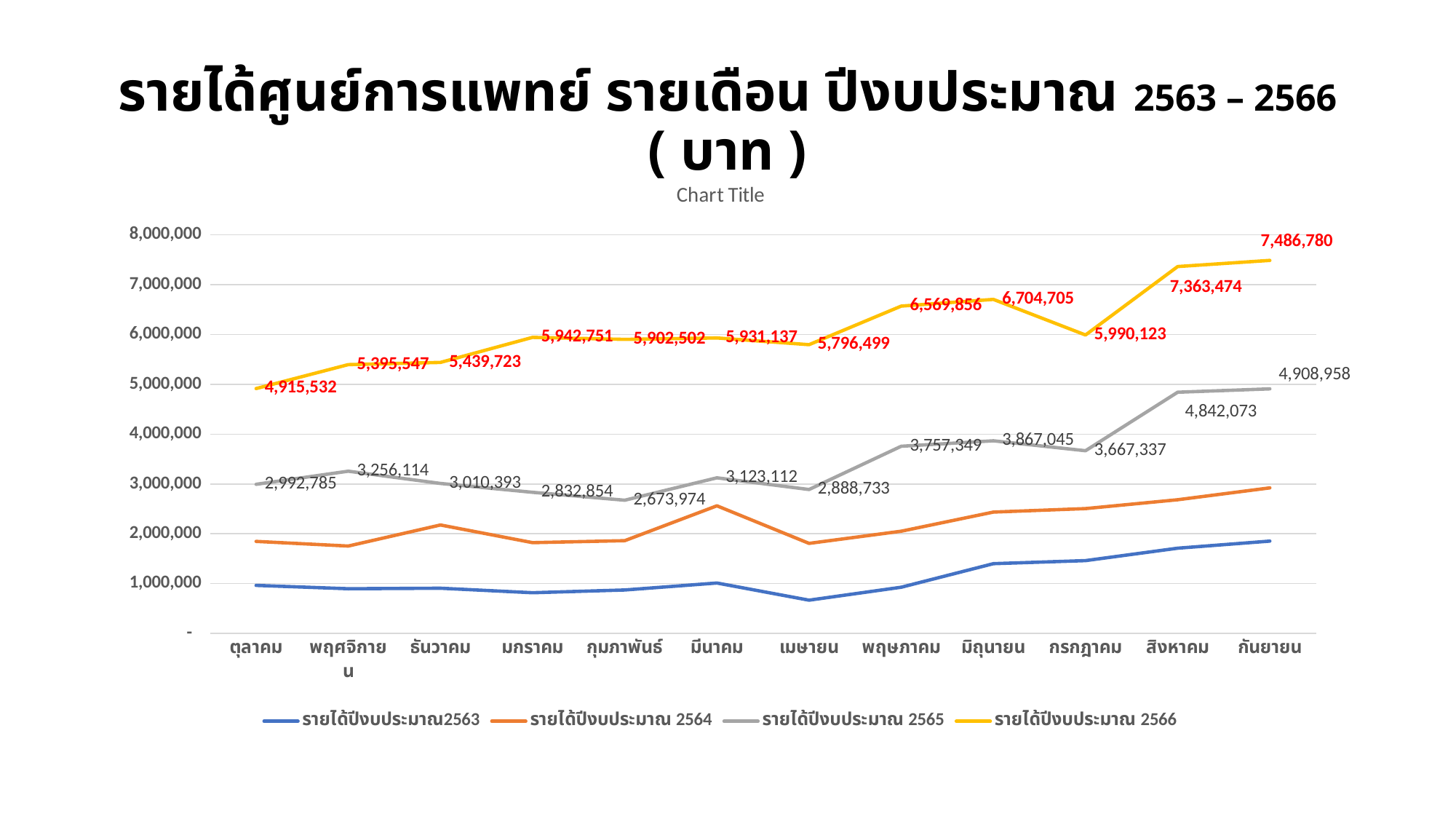
Is the value for รายได้ปีงบประมาณ 2564 in มีนาคม greater or less than 2,000,000? greater How many months are shown on the x axis? 12 Is the value for รายได้ปีงบประมาณ2563 in เมษายน greater or less than 1,000,000? less What is the value for รายได้ปีงบประมาณ 2566 in กรกฎาคม? 5,990,123 In which month is รายได้ปีงบประมาณ 2565 highest? กันยายน Which is larger for รายได้ปีงบประมาณ 2565: มิถุนายน or กรกฎาคม? มิถุนายน What kind of chart is shown on the slide? line chart How many series does the legend list? 4 What is the difference between รายได้ปีงบประมาณ 2566 in กันยายน and in ตุลาคม? 2,571,248 What is the value for รายได้ปีงบประมาณ 2566 in กันยายน? 7,486,780 In which month is รายได้ปีงบประมาณ 2566 lowest? ตุลาคม What is the value for รายได้ปีงบประมาณ 2565 in กุมภาพันธ์? 2,673,974